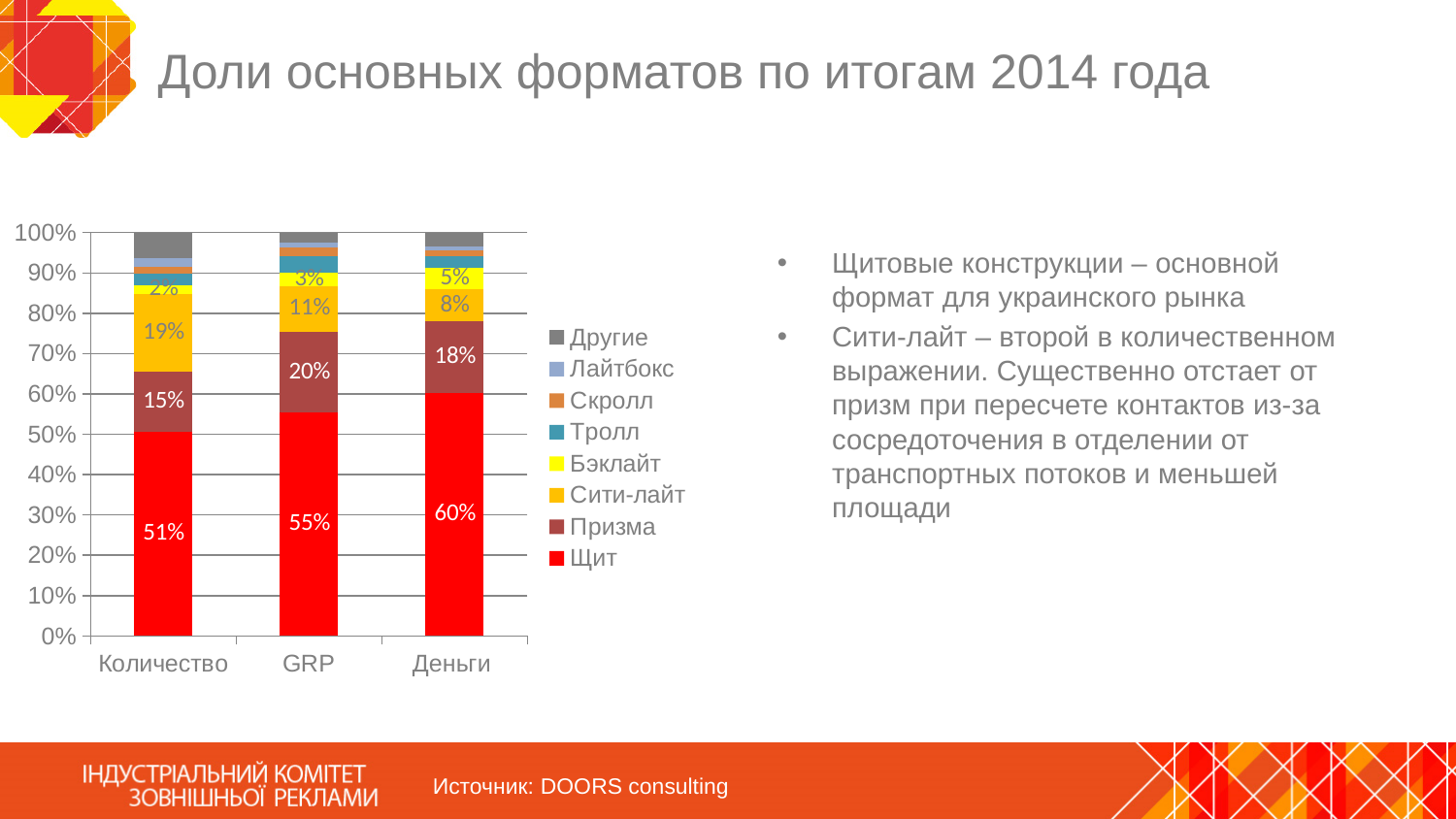
What share does Щит have in the Количество bar? 51% How many categories are shown on the x axis? 3 What share does Бэклайт have in the Деньги bar? 5% What share does Призма have in the GRP bar? 20% What share does Сити-лайт have in the Количество bar? 19% What kind of chart is shown on the slide? Stacked bar chart What is the difference between the Щит share in Деньги and in Количество? 9% Which is larger: the Призма share in GRP or in Деньги? GRP In which category is the Щит share the highest? Деньги What share does Щит have in the Деньги bar? 60% In which category is the Сити-лайт share the lowest? Деньги How many series does the legend list? 8